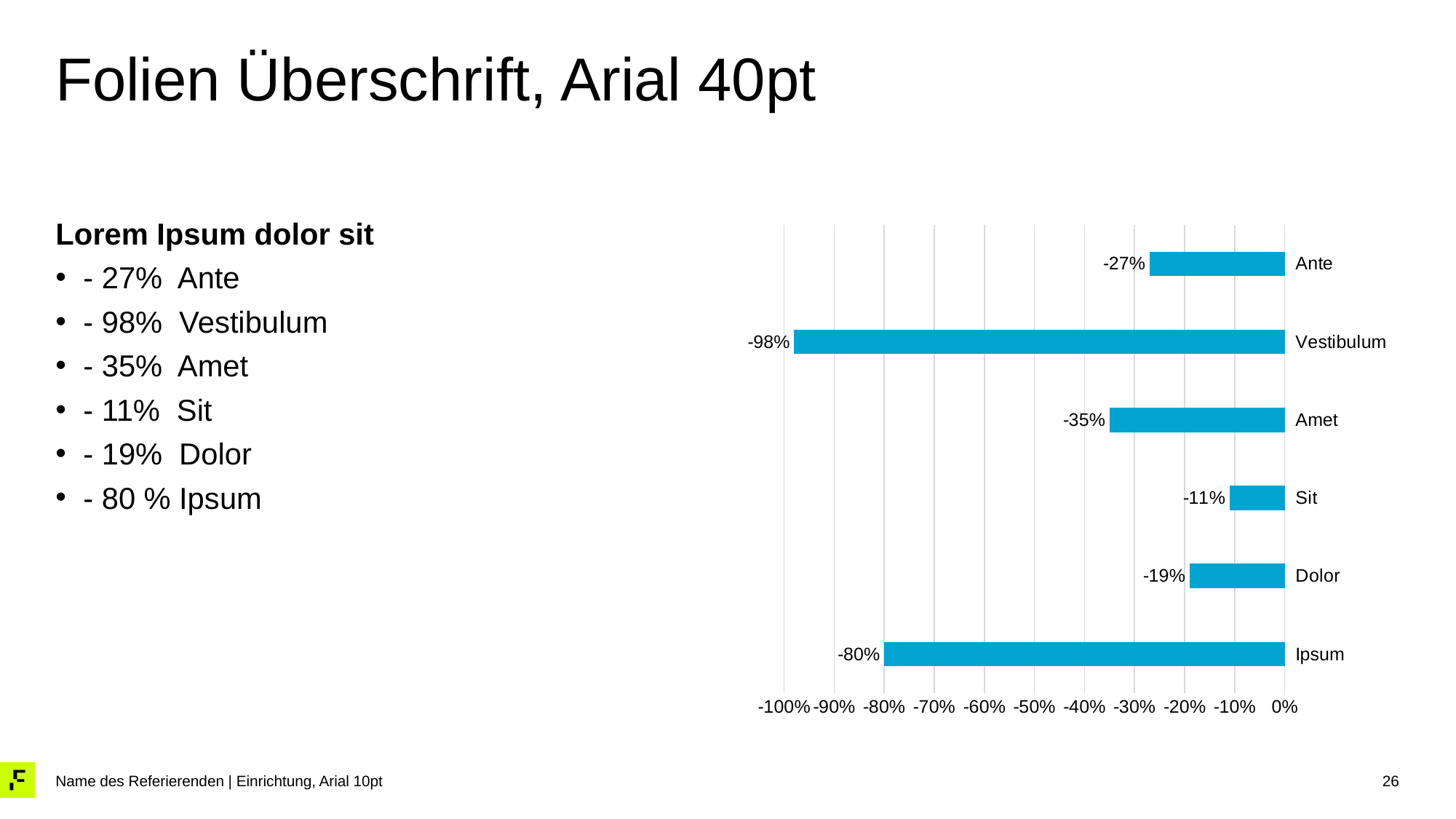
Which category has the lowest (most negative) value? Vestibulum What is the value for Ipsum? -80% What is the difference between the values for Vestibulum and Ipsum? 18 percentage points Which bar is longer, Ante or Dolor? Ante How many categories are shown in the chart? 6 What is the value for Ante? -27% What is the value for Vestibulum? -98% Which category has the shortest bar? Sit Is the value for Amet greater or less than -50%? greater What kind of chart is shown on the slide? Bar chart What is the value for Sit? -11% What is the leftmost tick label on the horizontal axis? -100%